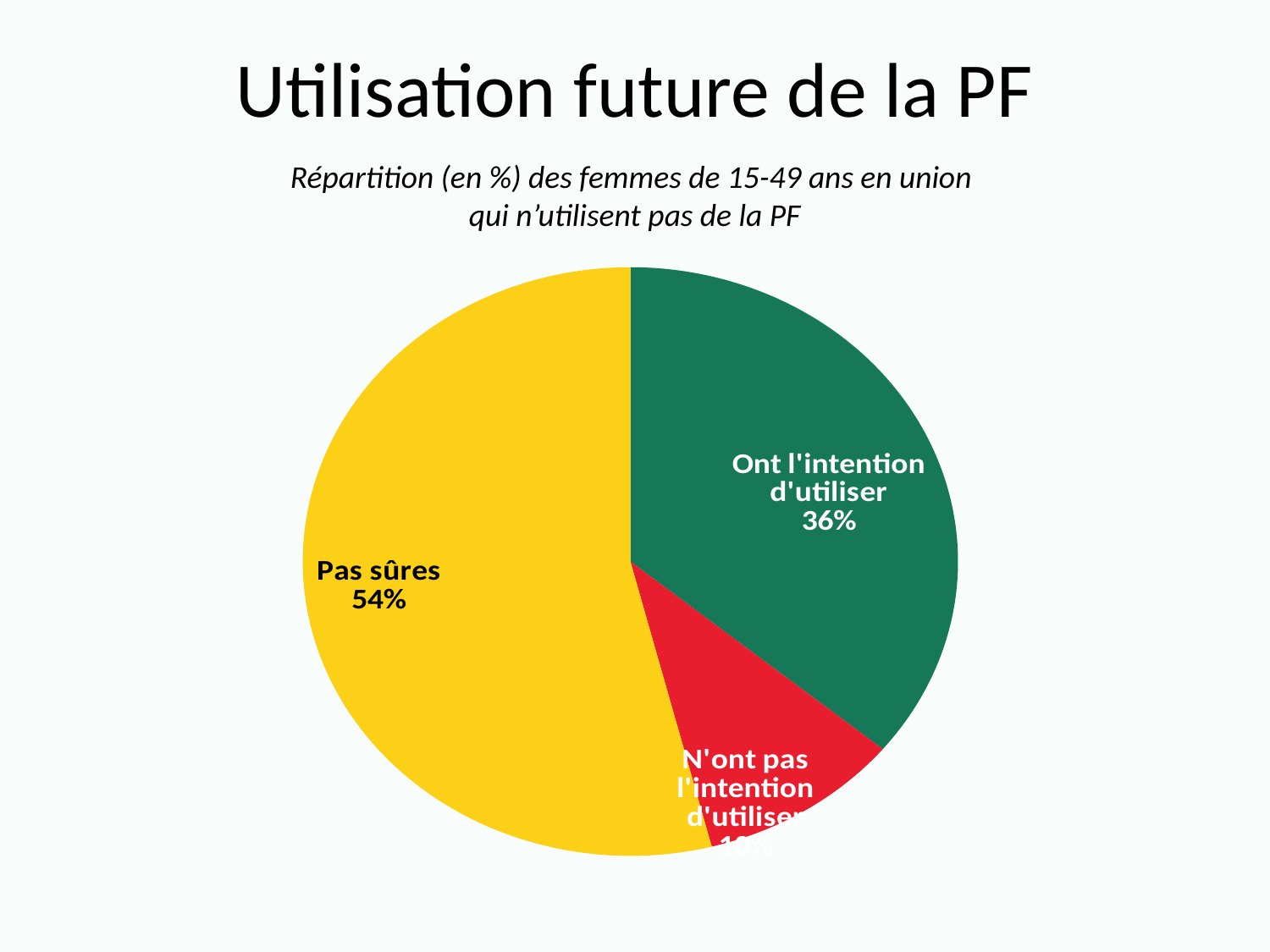
What is the difference between the "Pas sûres" share and the "Ont l'intention d'utiliser" share? 18% What colour is the "Pas sûres" slice? yellow What percentage of the pie is labelled "Pas sûres"? 54% What share of the pie does the "Pas sûres" slice represent? 54% Which slice of the pie chart is the largest? Pas sûres What percentage of the pie is labelled "Ont l'intention d'utiliser"? 36% What is the title of the slide? Utilisation future de la PF What kind of chart is shown on the slide? pie chart Is the "Pas sûres" slice greater or less than 50% of the pie? greater Which is larger: the "Pas sûres" slice or the "Ont l'intention d'utiliser" slice? Pas sûres Which slice of the pie chart is the smallest? N'ont pas l'intention d'utiliser How many slices does the pie chart have? 3